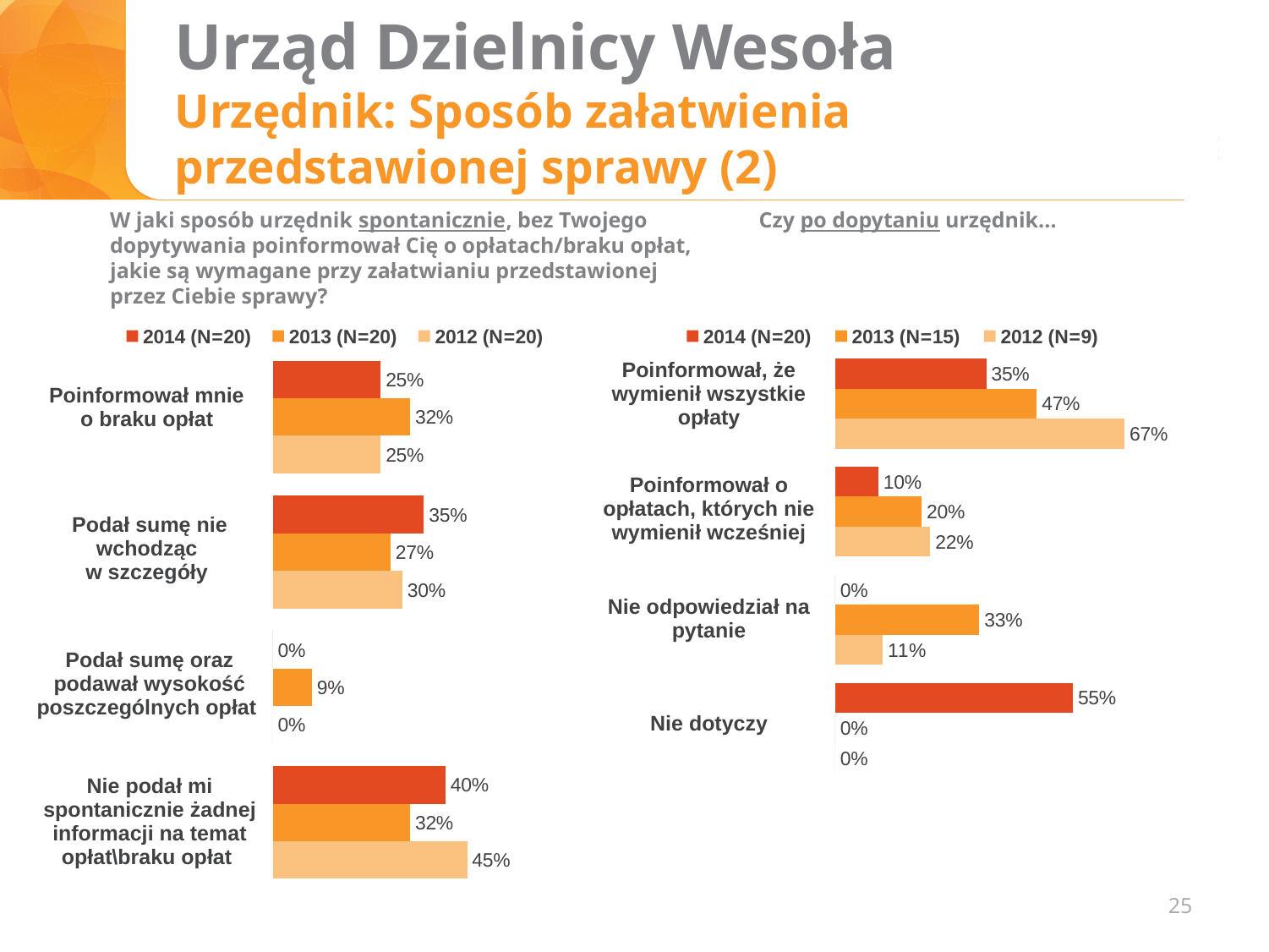
In the right chart, what is the 2013 (N=15) value for "Nie odpowiedział na pytanie"? 33% In the left chart, what is the 2014 (N=20) value for "Nie podał mi spontanicznie żadnej informacji na temat opłat\braku opłat"? 40% In the right chart, which category has the lowest 2013 (N=15) value? Nie dotyczy How many series does the legend of the right chart list? 3 In the left chart, which category has the highest 2012 (N=20) value? Nie podał mi spontanicznie żadnej informacji na temat opłat\braku opłat In the right chart, what is the 2014 (N=20) value for "Nie dotyczy"? 55% In the left chart, which is larger for "Podał sumę nie wchodząc w szczegóły": the 2014 (N=20) value or the 2013 (N=20) value? 2014 (N=20) What type of chart is the right chart? Bar chart In the left chart, what is the 2013 (N=20) value for "Podał sumę oraz podawał wysokość poszczególnych opłat"? 9% How many categories does the left chart show? 4 In the right chart, what is the 2012 (N=9) value for "Poinformował, że wymienił wszystkie opłaty"? 67% In the right chart, what is the difference between the 2012 (N=9) and 2014 (N=20) values for "Poinformował, że wymienił wszystkie opłaty"? 32%